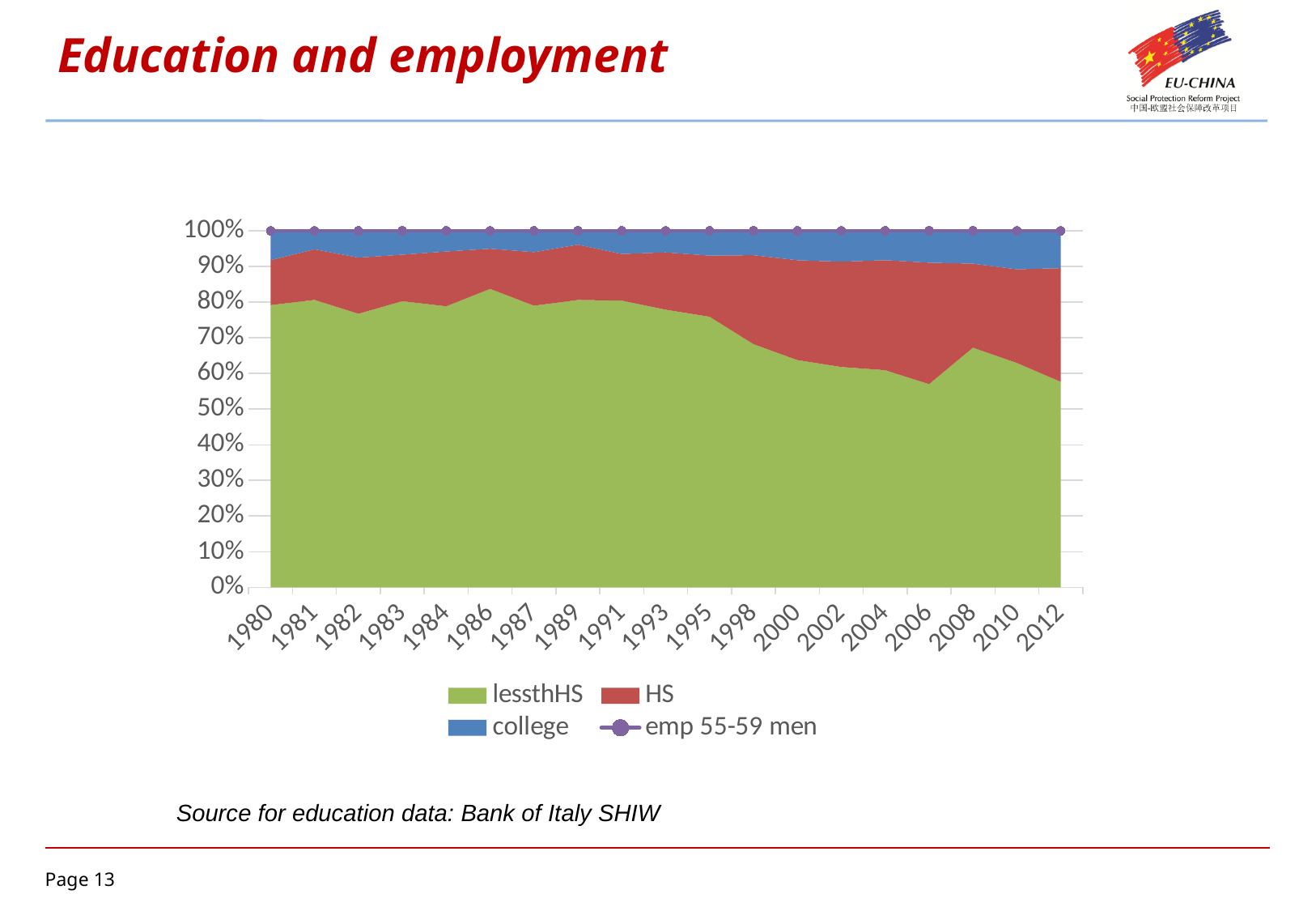
What is the first year shown on the x axis? 1980 Is the value for lessthHS in 2006 greater or less than 60%? less What kind of chart is shown on the slide? Stacked area chart with a line Is the value for lessthHS in 1986 greater or less than 80%? greater Which series is shown in green? lessthHS Is the value of the emp 55-59 men line in 2000 greater or less than 90%? greater How many series does the legend list? 4 How many years are shown on the x axis? 19 Does the share of lessthHS rise or fall from 1980 to 2012? fall Which is larger in 1980, the lessthHS share or the HS share? lessthHS